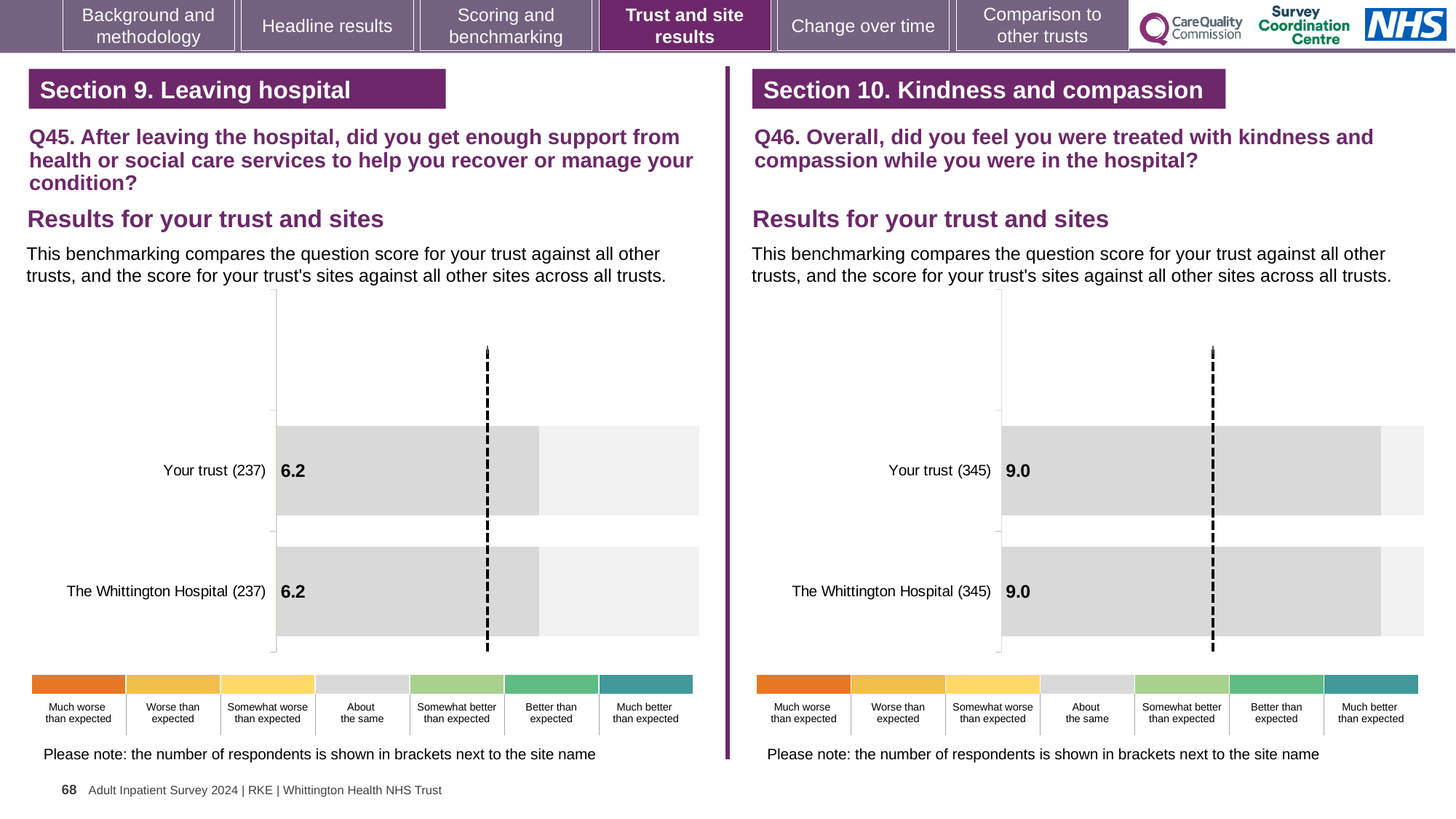
On the Q45 chart (left), what is the score for The Whittington Hospital? 6.2 On the Q46 chart (right), how many bars are plotted? 2 On the Q45 chart (left), what is the score for Your trust? 6.2 On the Q46 chart (right), how many respondents are shown in brackets for The Whittington Hospital? 345 What kind of chart is the Q45 chart (left)? Bar chart On the Q46 chart (right), which benchmark category does the grey colour of the bars correspond to in the key? About the same On the Q45 chart (left), what is the difference between the score for Your trust and the score for The Whittington Hospital? 0.0 How many categories are listed in the colour key below the Q45 chart (left)? 7 On the Q46 chart (right), what is the score for The Whittington Hospital? 9.0 Is the score for Your trust on the Q46 chart (right) larger or smaller than the score for Your trust on the Q45 chart (left)? Larger On the Q45 chart (left), how many respondents are shown in brackets for Your trust? 237 On the Q46 chart (right), what is the score for Your trust? 9.0